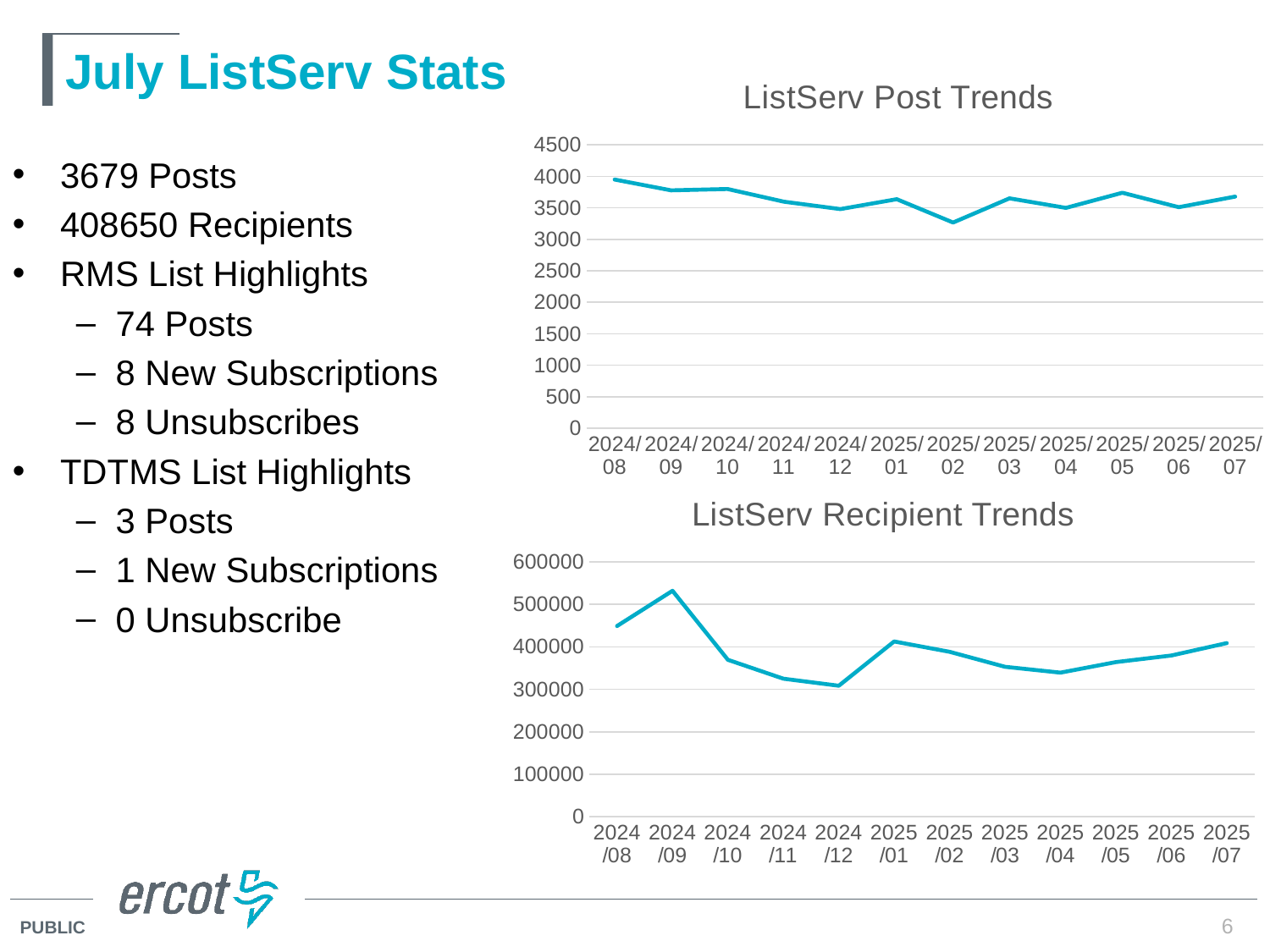
On the ListServ Post Trends chart, is the value for 2024/08 greater or less than 3500? greater On the ListServ Recipient Trends chart, which is larger, the value for 2024/09 or the value for 2024/12? 2024/09 What is the title of the lower chart on the slide? ListServ Recipient Trends On the ListServ Post Trends chart, is the value for 2025/02 greater or less than 3500? less How many data points are plotted on the ListServ Post Trends chart? 12 On the ListServ Recipient Trends chart, is the value for 2024/09 greater or less than 500000? greater On the ListServ Recipient Trends chart, which month has the lowest value? 2024/12 On the ListServ Post Trends chart, which month has the lowest value? 2025/02 What kind of chart is the ListServ Post Trends chart? line chart On the ListServ Post Trends chart, which month has the highest value? 2024/08 On the ListServ Recipient Trends chart, which month has the highest value? 2024/09